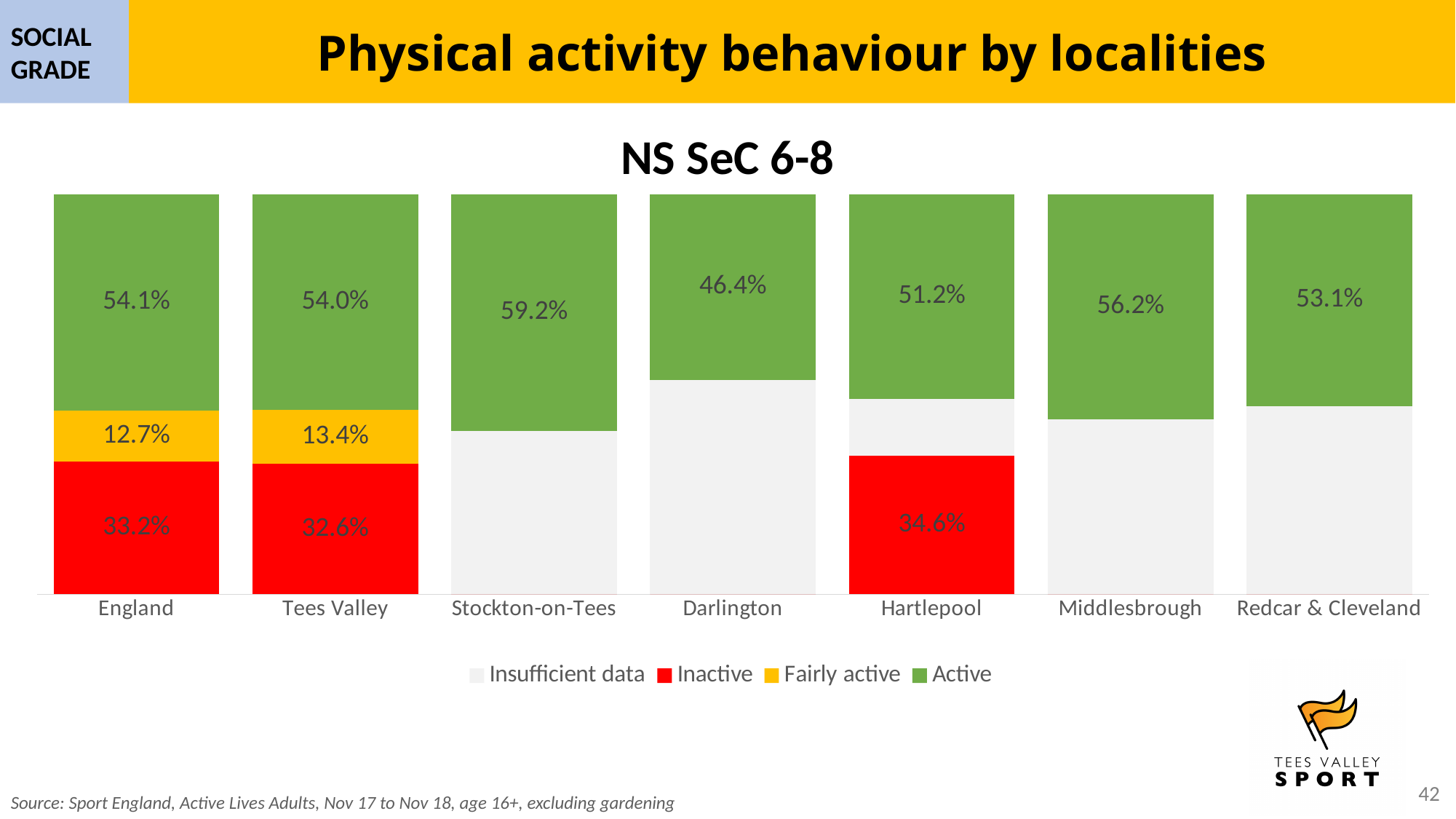
Which locality has the lowest Active percentage? Darlington What is the Active percentage for Stockton-on-Tees? 59.2% How many series does the legend list? 4 What is the Inactive percentage for Hartlepool? 34.6% What is the difference between the Active percentages for Stockton-on-Tees and Darlington? 12.8% How many localities are shown on the x axis? 7 What is the Active percentage for Darlington? 46.4% What kind of chart is shown? Stacked bar chart What is the title of the chart? NS SeC 6-8 Which locality has the highest Active percentage? Stockton-on-Tees Which has a higher Inactive percentage, England or Tees Valley? England What is the Fairly active percentage for Tees Valley? 13.4%